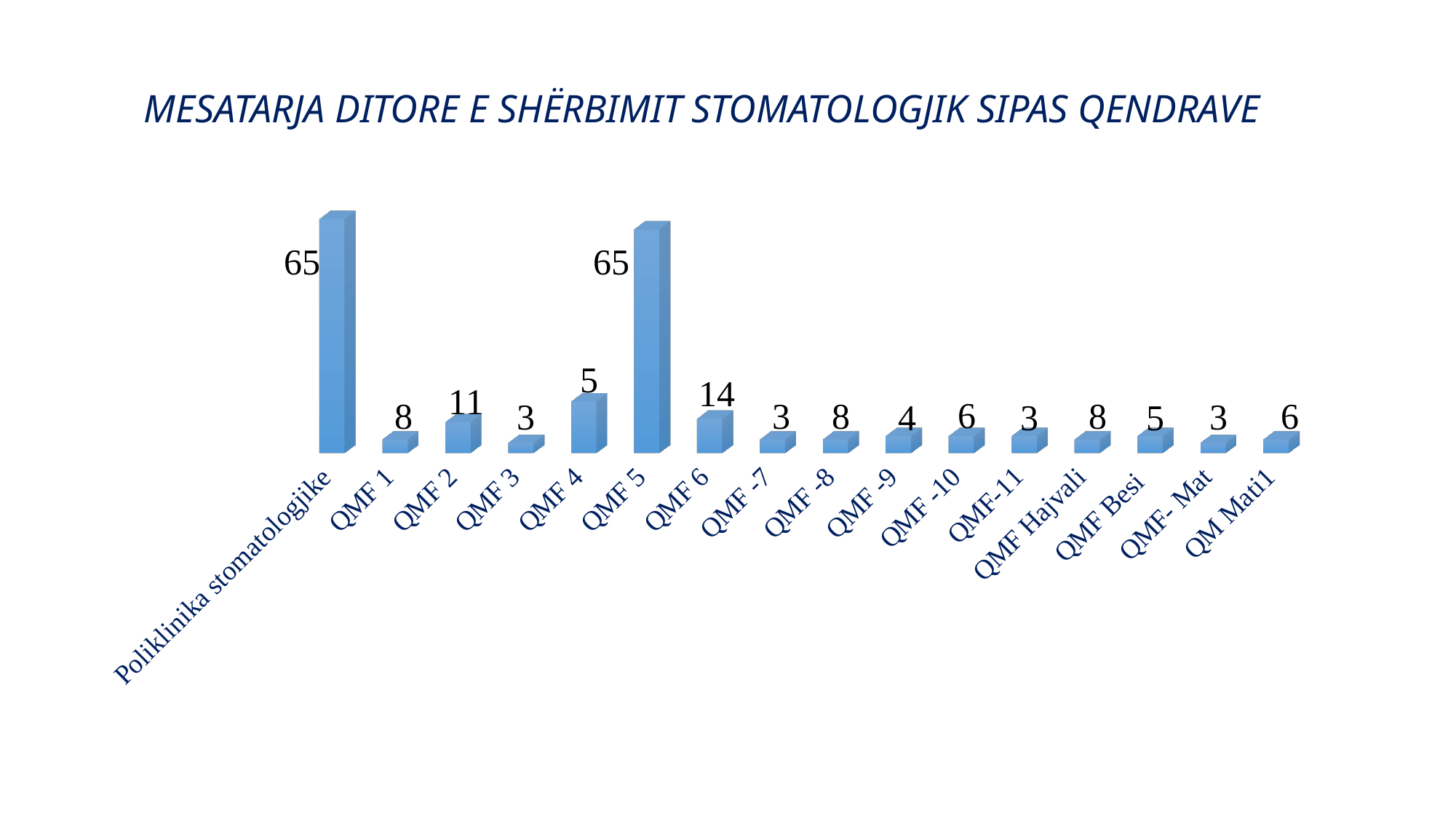
What is the value for QMF 6? 14 What type of chart is shown on the slide? bar chart What is the title of the chart? MESATARJA DITORE E SHËRBIMIT STOMATOLOGJIK SIPAS QENDRAVE What is the highest value shown in the chart? 65 What is the value for QMF 2? 11 What is the value for QM Mati1? 6 What is the difference between the values for QMF 2 and QMF 1? 3 What is the difference between the values for QMF 5 and QMF 6? 51 What is the value for QMF Hajvali? 8 What is the value for Poliklinika stomatologjike? 65 How many categories are shown on the x axis? 16